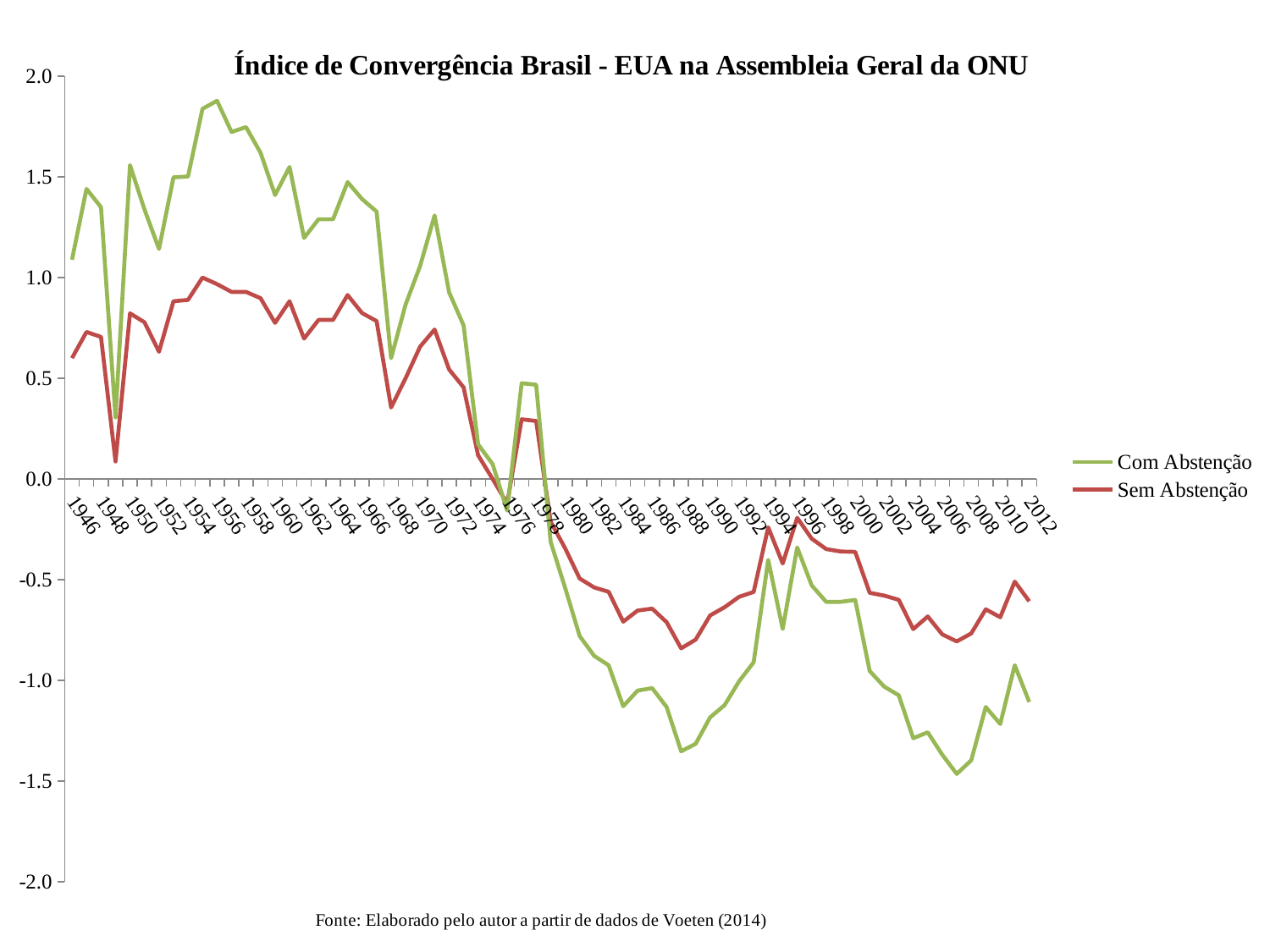
Is the value for Sem Abstenção in 2012 greater or less than -1.0? greater Which series is drawn in red? Sem Abstenção What is the title of the chart? Índice de Convergência Brasil - EUA na Assembleia Geral da ONU In 1956, which series has the higher value, Com Abstenção or Sem Abstenção? Com Abstenção In 2006, which series has the higher value, Com Abstenção or Sem Abstenção? Sem Abstenção Is the value for Com Abstenção in 2006 greater or less than -1.0? less How many series does the legend list? 2 Overall, do the values of the Com Abstenção series rise or fall from 1946 to 2012? fall What kind of chart is shown on the slide? line chart Is the value for Sem Abstenção in 1988 greater or less than -0.5? less